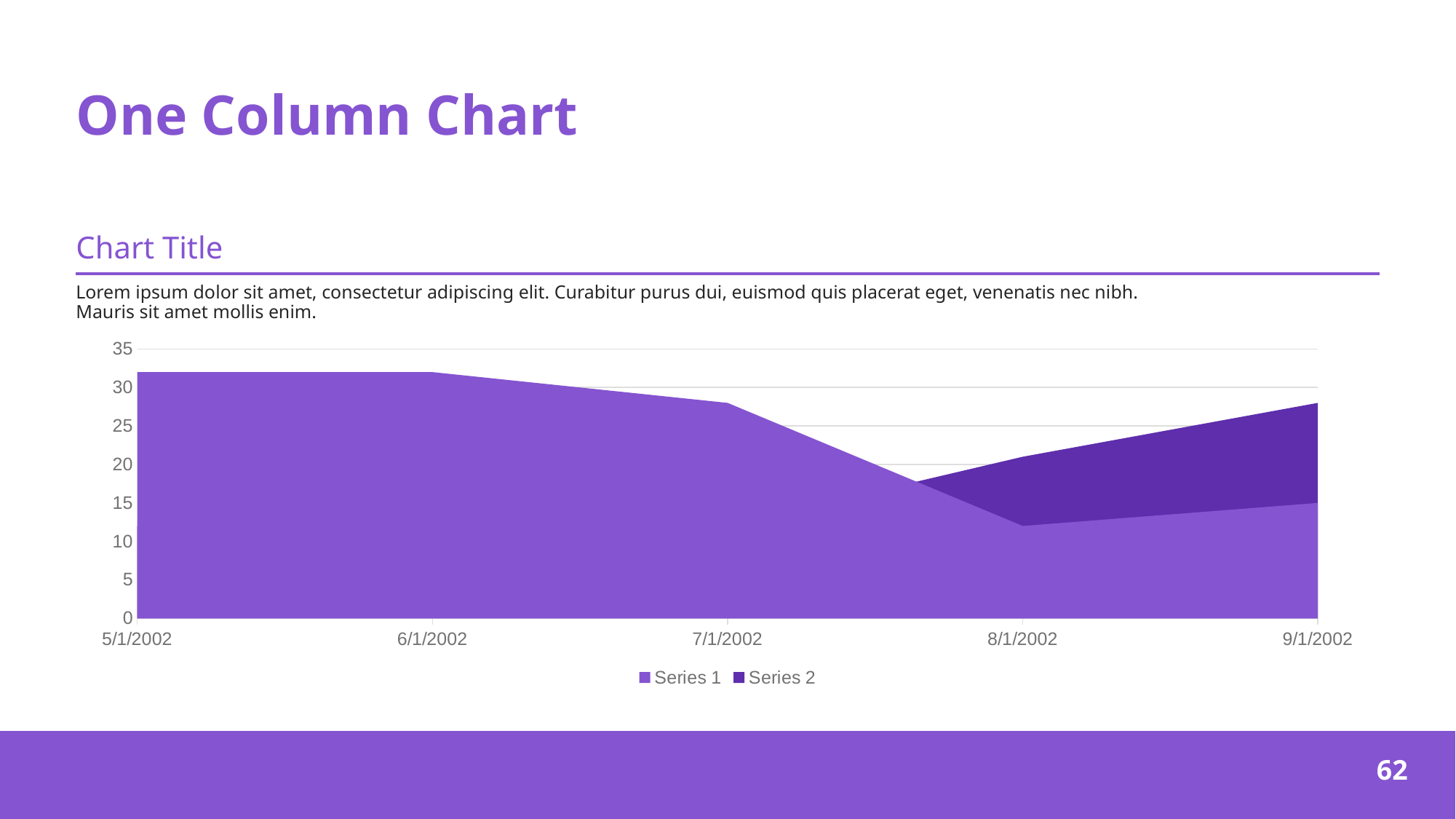
What are the names of the two series in the legend? Series 1 and Series 2 Does Series 1 generally rise or fall from 5/1/2002 to 8/1/2002? fall At which date is Series 1 lowest? 8/1/2002 Is the value for Series 1 at 7/1/2002 greater or less than 30? less Is the value for Series 1 at 9/1/2002 greater or less than 20? less Is the value for Series 1 at 5/1/2002 greater or less than 30? greater What kind of chart is shown on the slide? area chart What is the title shown above the chart? Chart Title How many dates are shown on the x axis? 5 Which is larger for Series 1: the value at 6/1/2002 or the value at 8/1/2002? 6/1/2002 How many series does the legend list? 2